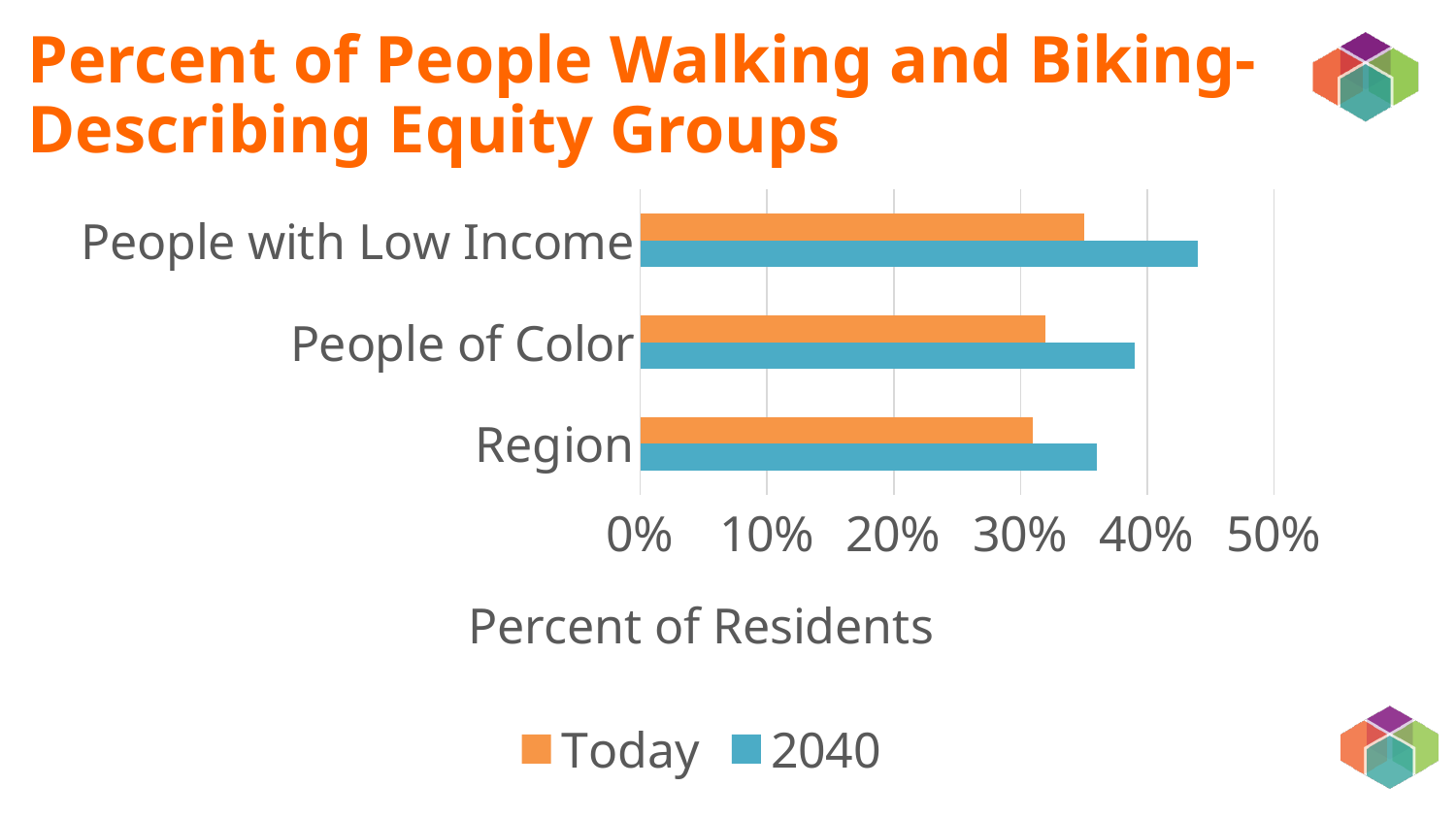
For People with Low Income, which is larger: the Today value or the 2040 value? 2040 Which category has the highest value for the 2040 series? People with Low Income What is the title of the horizontal axis? Percent of Residents What kind of chart is shown on the slide? bar chart Is the 2040 value for People with Low Income greater or less than 40%? greater Is the 2040 value for Region greater or less than 40%? less For Region, which is larger: the Today value or the 2040 value? 2040 How many equity groups (categories) are shown on the chart? 3 How many series does the legend list? 2 Which category has the lowest value for the 2040 series? Region Is the Today value for People with Low Income greater or less than 30%? greater Which category has the highest value for the Today series? People with Low Income